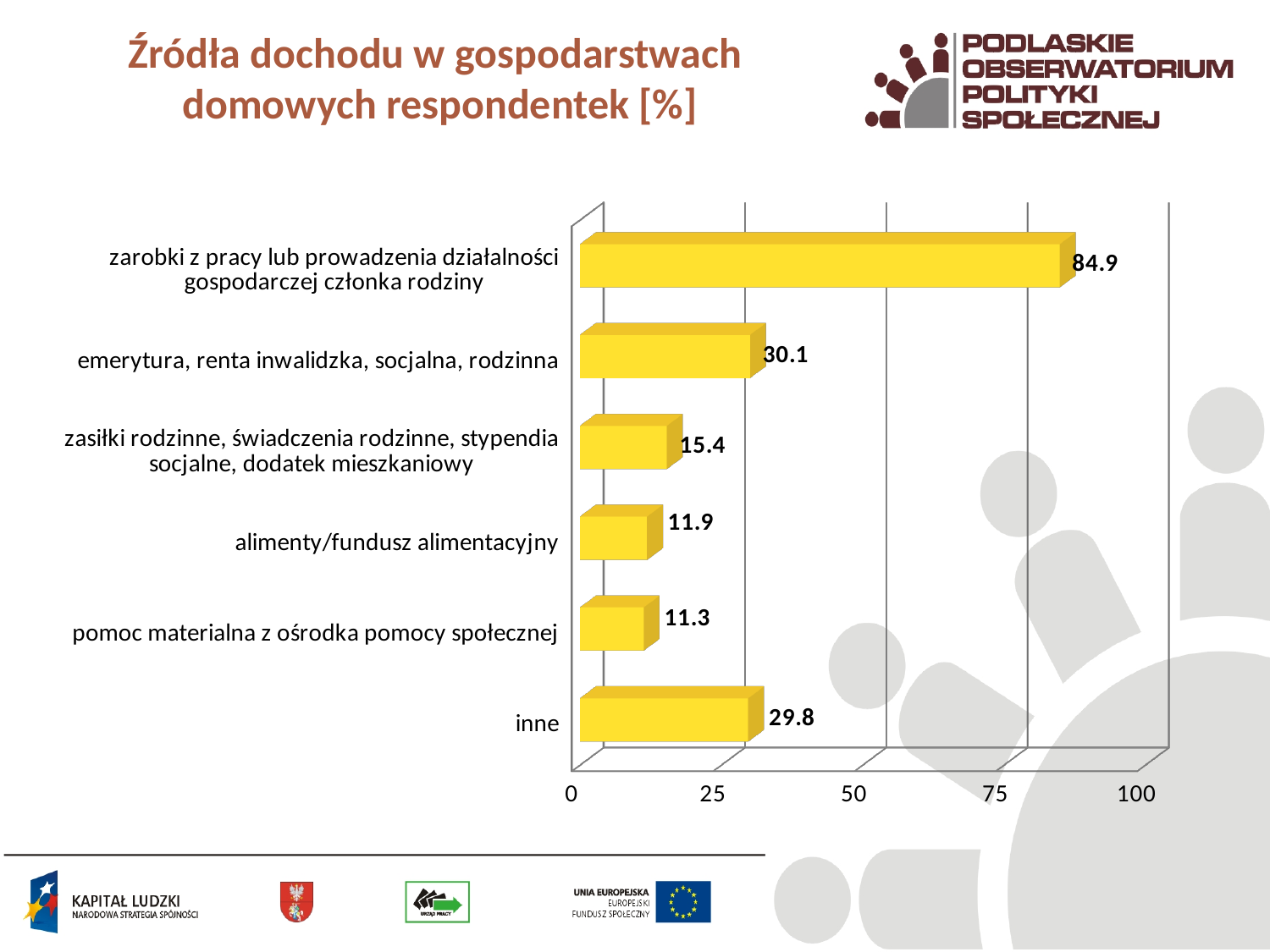
What is the value for 'inne'? 29.8 What is the difference between the values for 'emerytura, renta inwalidzka, socjalna, rodzinna' and 'inne'? 0.3 What is the value for 'emerytura, renta inwalidzka, socjalna, rodzinna'? 30.1 Is the value for 'emerytura, renta inwalidzka, socjalna, rodzinna' greater or less than 25? greater Which category has the lowest value? pomoc materialna z ośrodka pomocy społecznej What is the value for 'alimenty/fundusz alimentacyjny'? 11.9 What is the title of the chart on the slide? Źródła dochodu w gospodarstwach domowych respondentek [%] Which category has the highest value? zarobki z pracy lub prowadzenia działalności gospodarczej członka rodziny Which is larger: the value for 'zasiłki rodzinne, świadczenia rodzinne, stypendia socjalne, dodatek mieszkaniowy' or for 'alimenty/fundusz alimentacyjny'? zasiłki rodzinne, świadczenia rodzinne, stypendia socjalne, dodatek mieszkaniowy What is the value for 'zarobki z pracy lub prowadzenia działalności gospodarczej członka rodziny'? 84.9 How many categories are shown in the chart? 6 What kind of chart is shown on the slide? bar chart